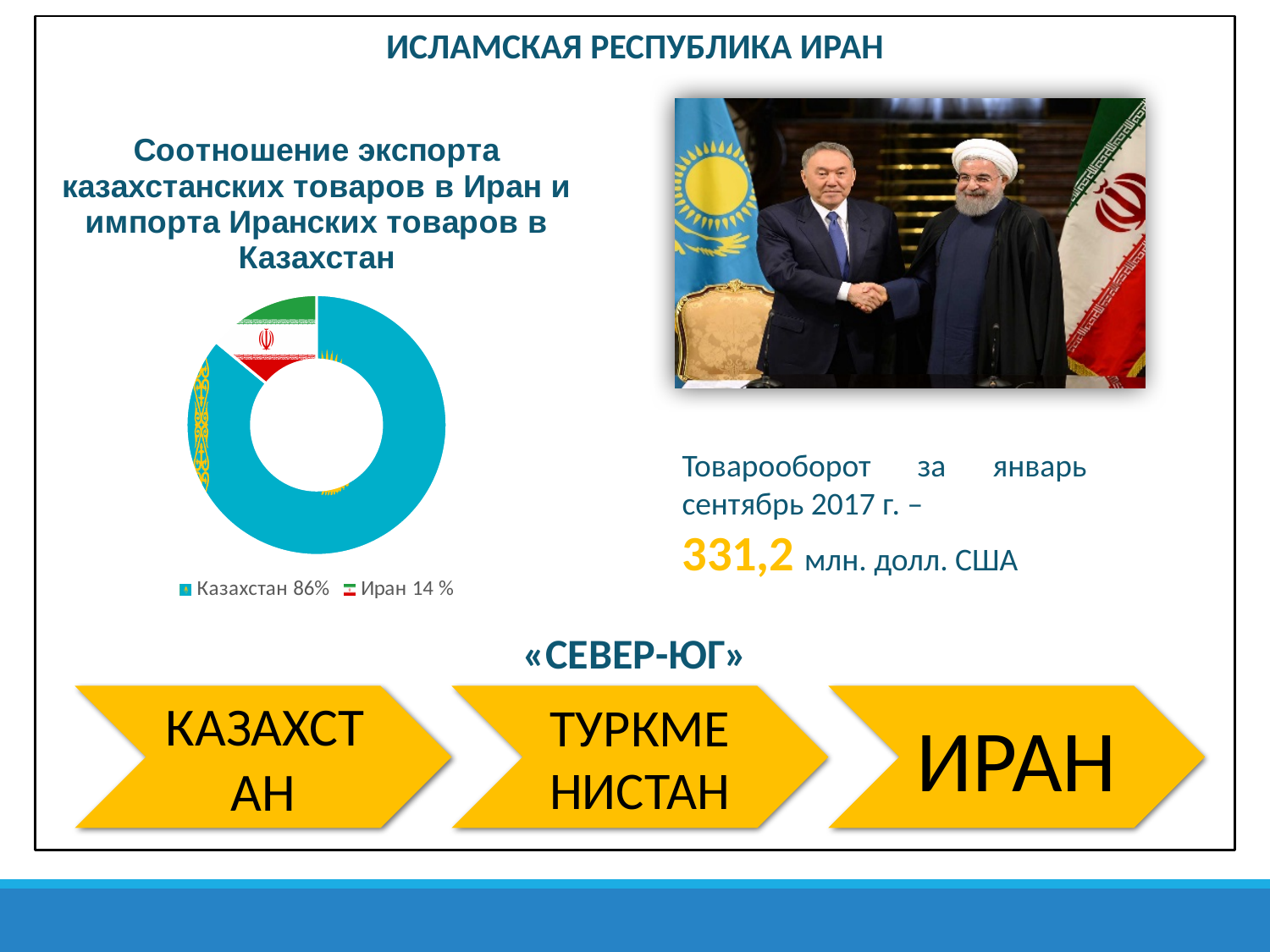
How many categories are shown in the doughnut chart? 2 What is the combined share of Казахстан and Иран in the doughnut chart? 100% What kind of chart is shown on the slide? Doughnut (pie) chart Which category has the largest share in the doughnut chart? Казахстан By how many percentage points does the share of Казахстан exceed the share of Иран in the doughnut chart? 72 What share of the doughnut chart does Иран account for? 14 % How many entries does the chart legend list? 2 Which category has the smallest share in the doughnut chart? Иран Which category has the larger share in the doughnut chart, Казахстан or Иран? Казахстан What is the title of the chart on the slide? Соотношение экспорта казахстанских товаров в Иран и импорта Иранских товаров в Казахстан What share of the doughnut chart does Казахстан account for? 86% Is the share for Казахстан in the doughnut chart greater or less than 50%? greater